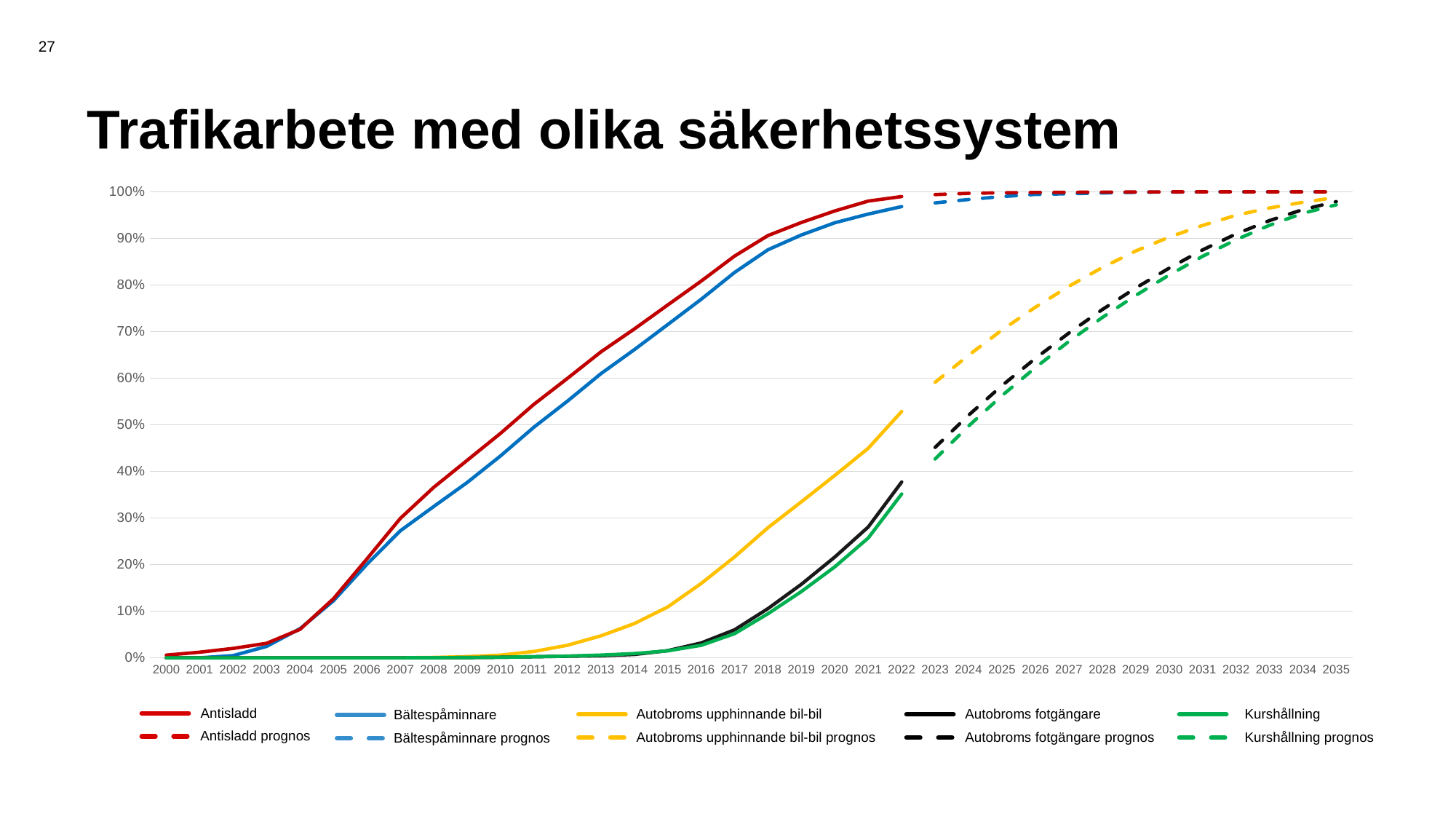
Does the Antisladd line rise or fall from 2000 to 2022? Rises Which series has the lowest value in 2022? Kurshållning How many series does the legend list? 10 Is the value for Kurshållning in 2022 greater or less than 40%? less How many years are shown on the x axis? 36 What kind of chart is shown on the slide? Line chart Which series has the highest value in 2022? Antisladd Is the value for Bältespåminnare in 2010 greater or less than 40%? greater Is the value for Autobroms upphinnande bil-bil prognos in 2023 greater or less than 50%? greater What is the title of the chart? Trafikarbete med olika säkerhetssystem In 2022, which is larger: Autobroms upphinnande bil-bil or Autobroms fotgängare? Autobroms upphinnande bil-bil